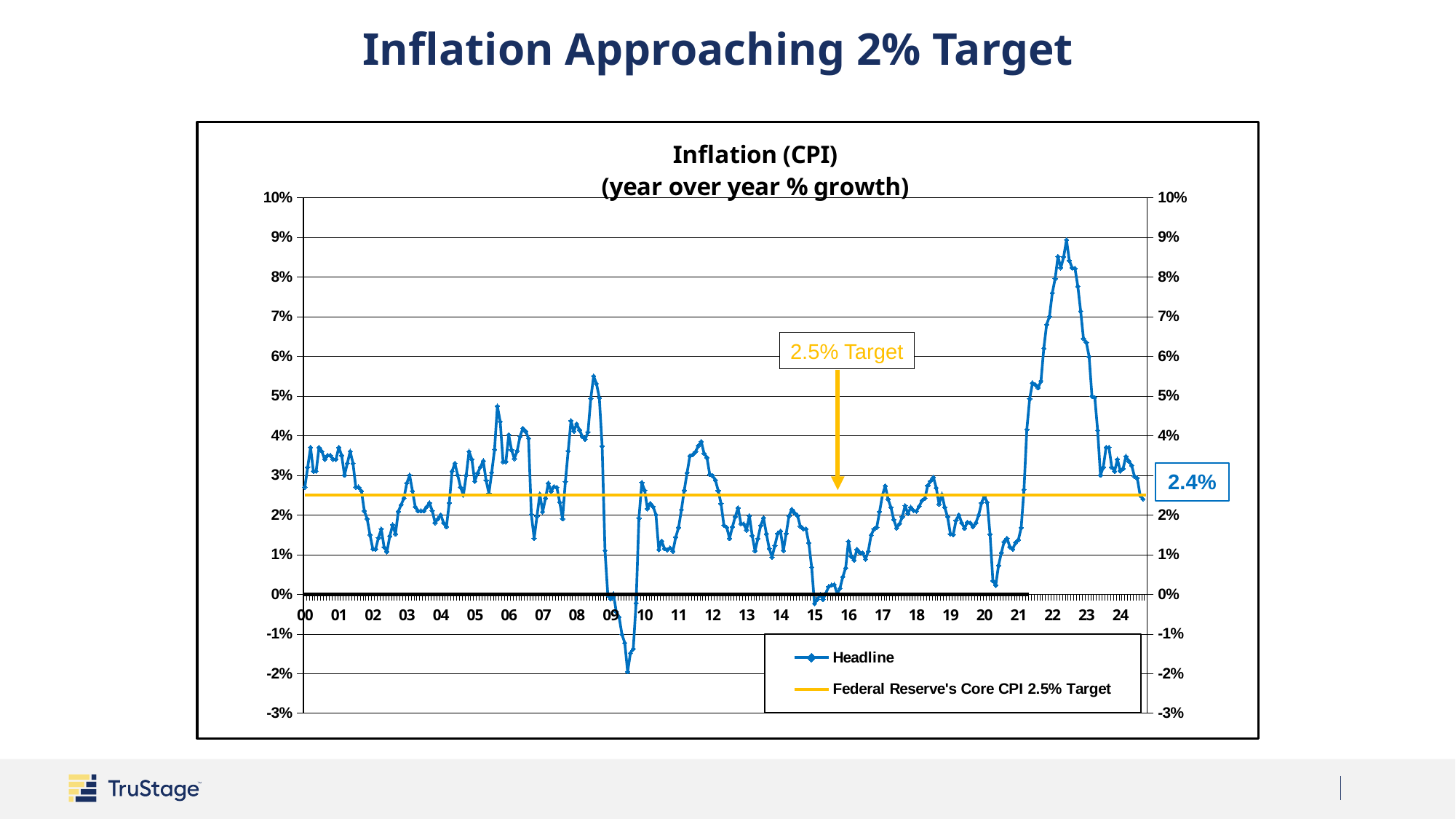
Which is larger, the latest Headline value of 2.4% or the Federal Reserve's 2.5% target? The 2.5% target How many series does the legend list? 2 Is the lowest Headline inflation value in 09 greater or less than -1%? less Is the peak Headline inflation value in 22 greater or less than 8%? greater In which year does the Headline inflation line reach its highest point? 22 In which year does the Headline inflation line reach its lowest point? 09 Does Headline inflation rise or fall from 22 to 24? Fall How many year labels are shown on the x axis? 25 What is the title printed inside the chart area? Inflation (CPI) (year over year % growth) What value does the Federal Reserve's Core CPI target line sit at? 2.5% What is the most recent Headline inflation value labeled on the chart? 2.4% What kind of chart is shown on the slide? Line chart